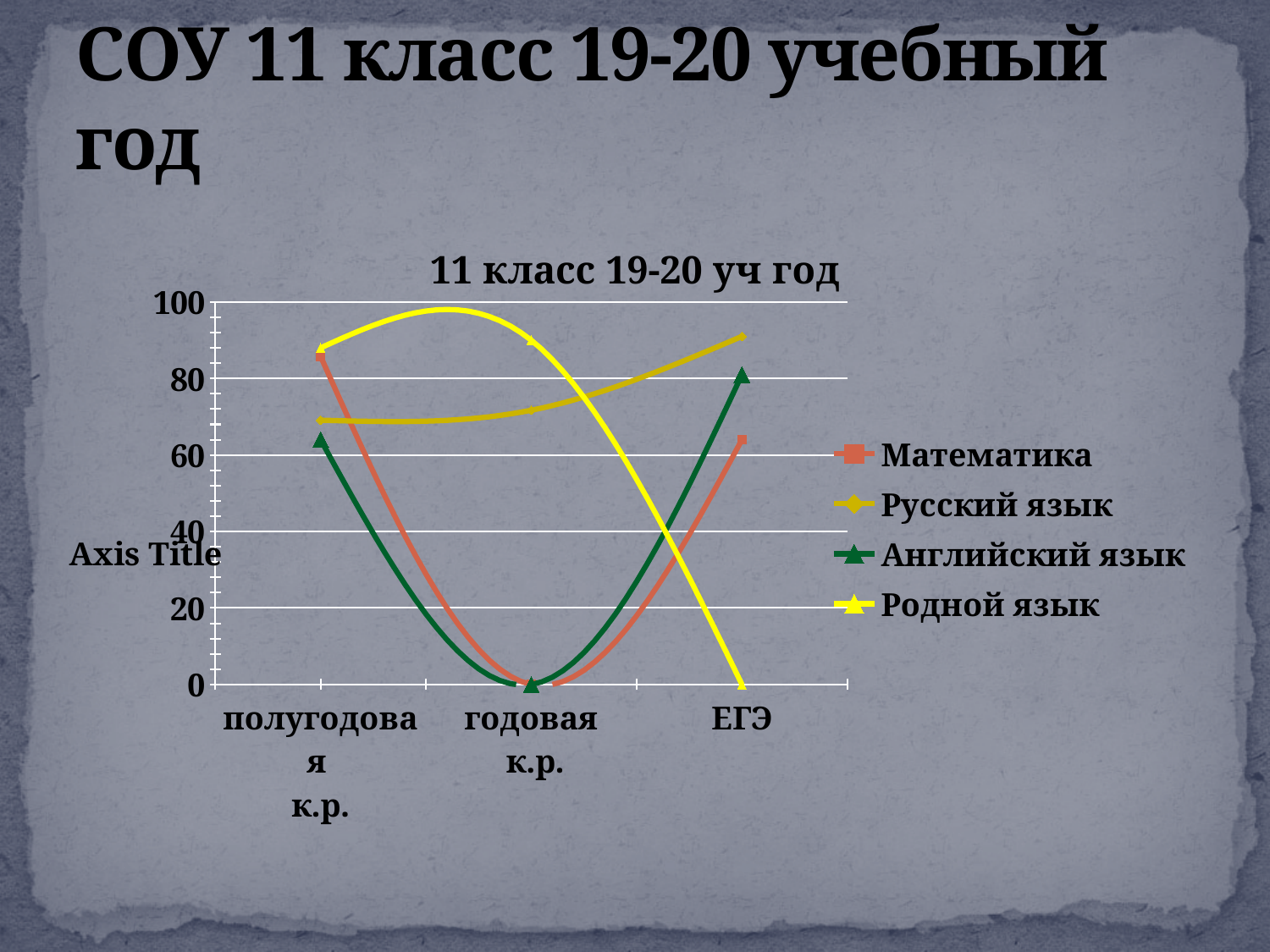
How many series does the legend list? 4 Is the value for Английский язык at ЕГЭ greater or less than 60? greater Which series has the lowest value at ЕГЭ? Родной язык Which series is drawn in green? Английский язык Which series has the highest value at ЕГЭ? Русский язык Is the value for Русский язык at ЕГЭ greater or less than 80? greater What kind of chart is shown on the slide? line chart How many categories are on the x axis? 3 Does the Русский язык series rise or fall from полугодовая к.р. to ЕГЭ? rise Is the value for Родной язык at ЕГЭ greater or less than 20? less What is the title of the chart? 11 класс 19-20 уч год